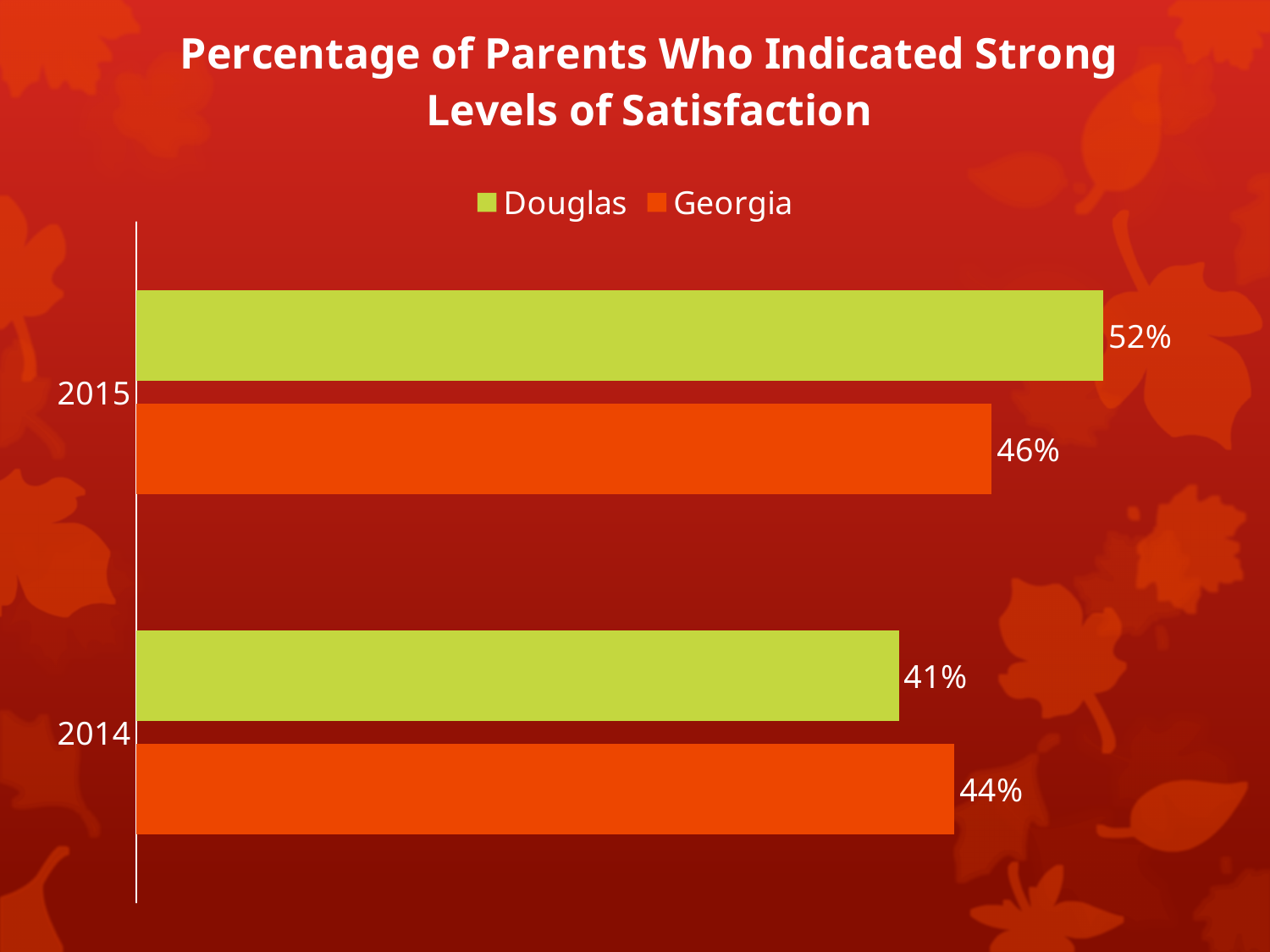
How many series does the legend list? 2 What is the value for Douglas in 2015? 52% Which series has the lowest value in 2014? Douglas What is the difference between Douglas and Georgia in 2015? 6% How many years are shown on the chart? 2 What kind of chart is shown on the slide? Bar chart What is the difference between Douglas in 2015 and Douglas in 2014? 11% What is the value for Douglas in 2014? 41% What is the value for Georgia in 2014? 44% Which is larger in 2014, Douglas or Georgia? Georgia Which series has the highest value in 2015? Douglas What is the value for Georgia in 2015? 46%